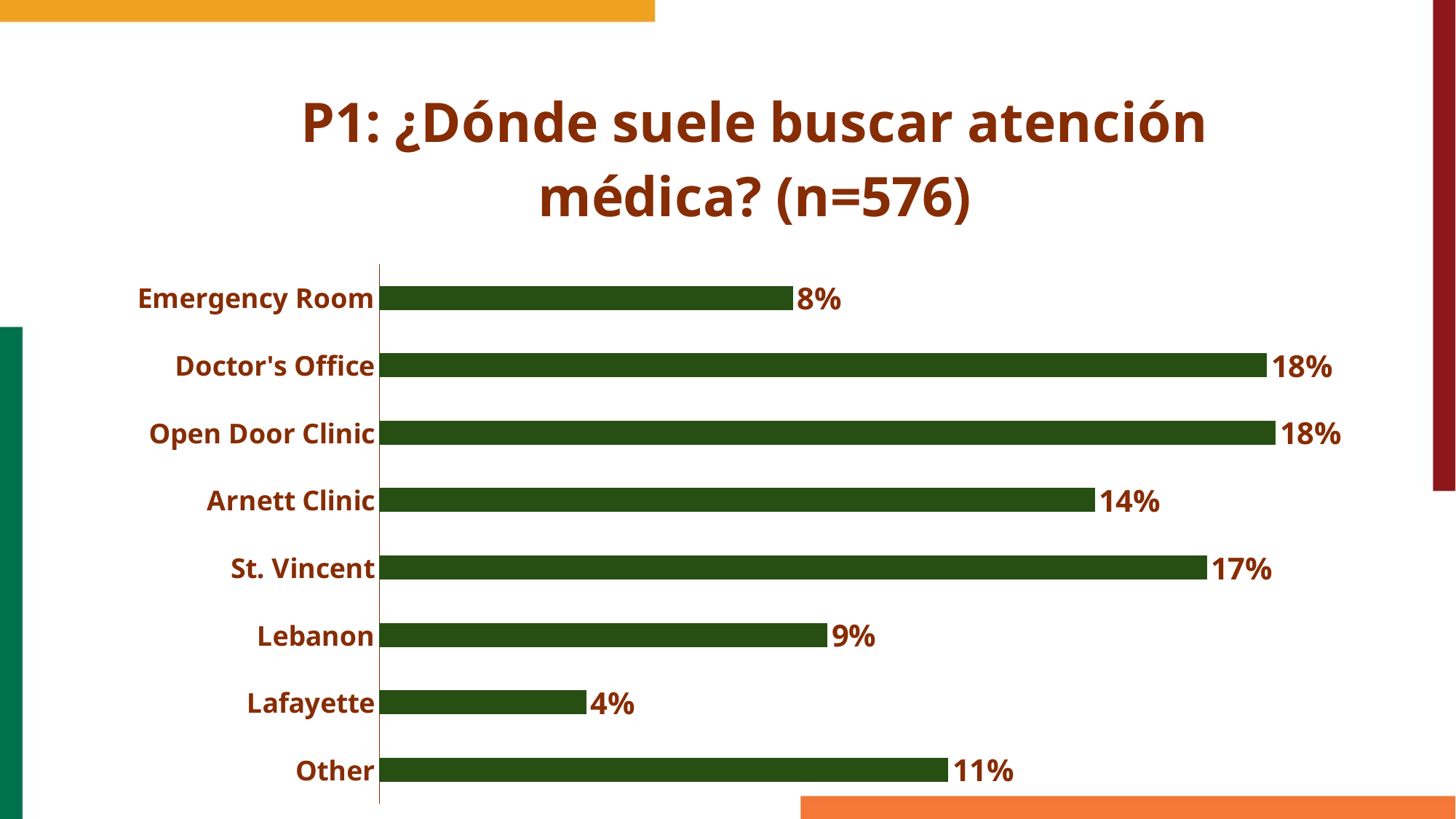
Which category has the lowest value? Lafayette What is the sample size (n) given in the chart title? 576 What is the difference between the values for Arnett Clinic and Lafayette? 10% Which is larger, the value for Emergency Room or the value for Arnett Clinic? Arnett Clinic What is the value for St. Vincent? 17% What is the value for Other? 11% What kind of chart is shown on the slide? Bar chart How many categories are shown in the chart? 8 What is the value for Arnett Clinic? 14% Which is larger, the value for Other or the value for Lebanon? Other What is the value for Emergency Room? 8% What is the difference between the values for St. Vincent and Lebanon? 8%